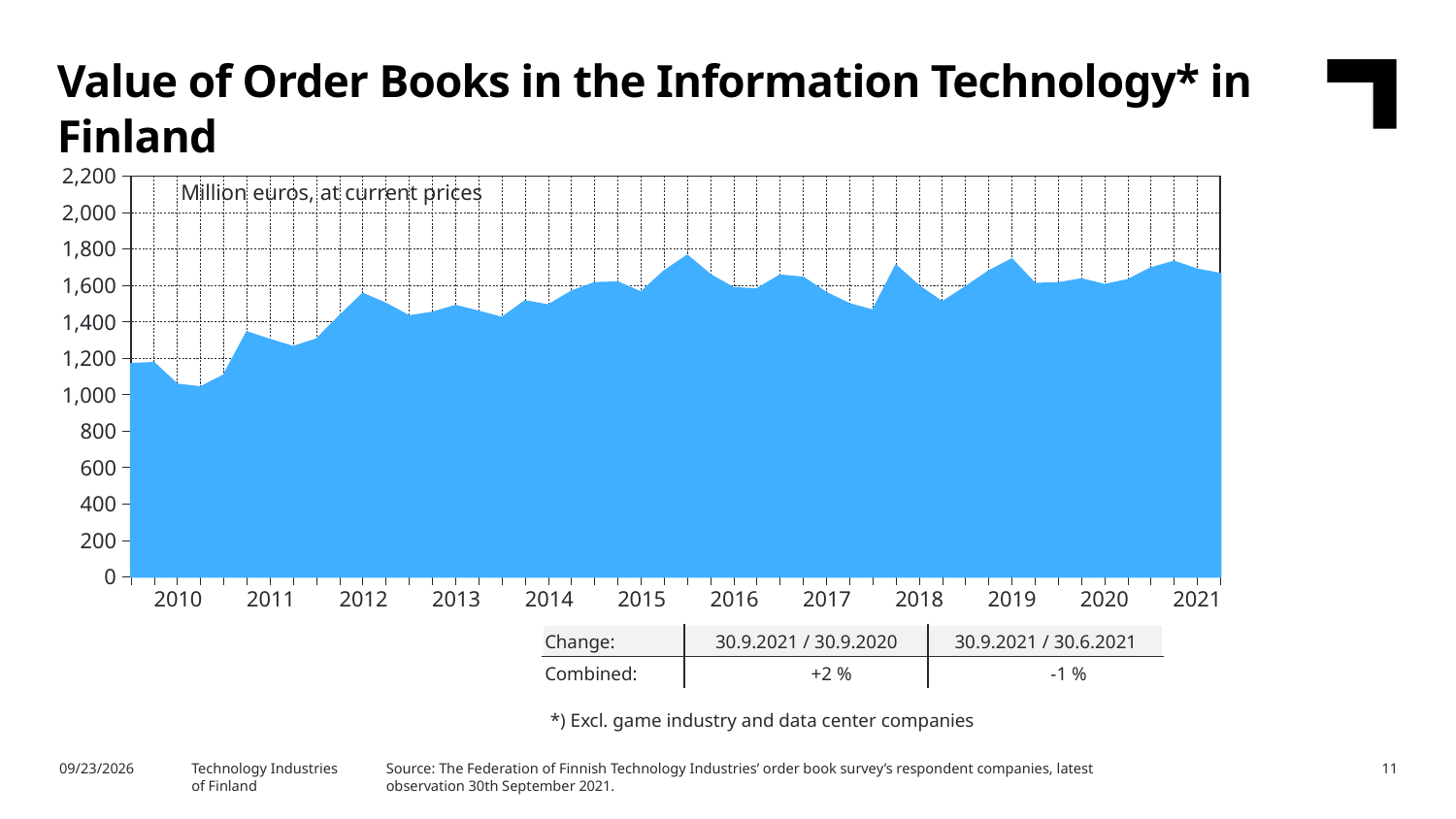
According to the table below the chart, what is the combined change for 30.9.2021 / 30.9.2020? +2 % In what unit are the values on the chart expressed, according to the label inside the plot area? Million euros, at current prices Is the value of order books at 2021 greater or less than 1,400? greater Is the value of order books at the start of 2010 greater or less than 1,400? less How many years are labelled on the x axis of the chart? 12 Is the value of order books at the start of 2018 greater or less than 1,400? greater What is the title of the chart? Value of Order Books in the Information Technology* in Finland What kind of chart is shown on the slide? area chart In which year labelled on the x axis is the value of order books at its lowest? 2010 Overall, do the values of order books rise or fall from 2010 to 2021? rise What is the highest value shown on the y axis of the chart? 2,200